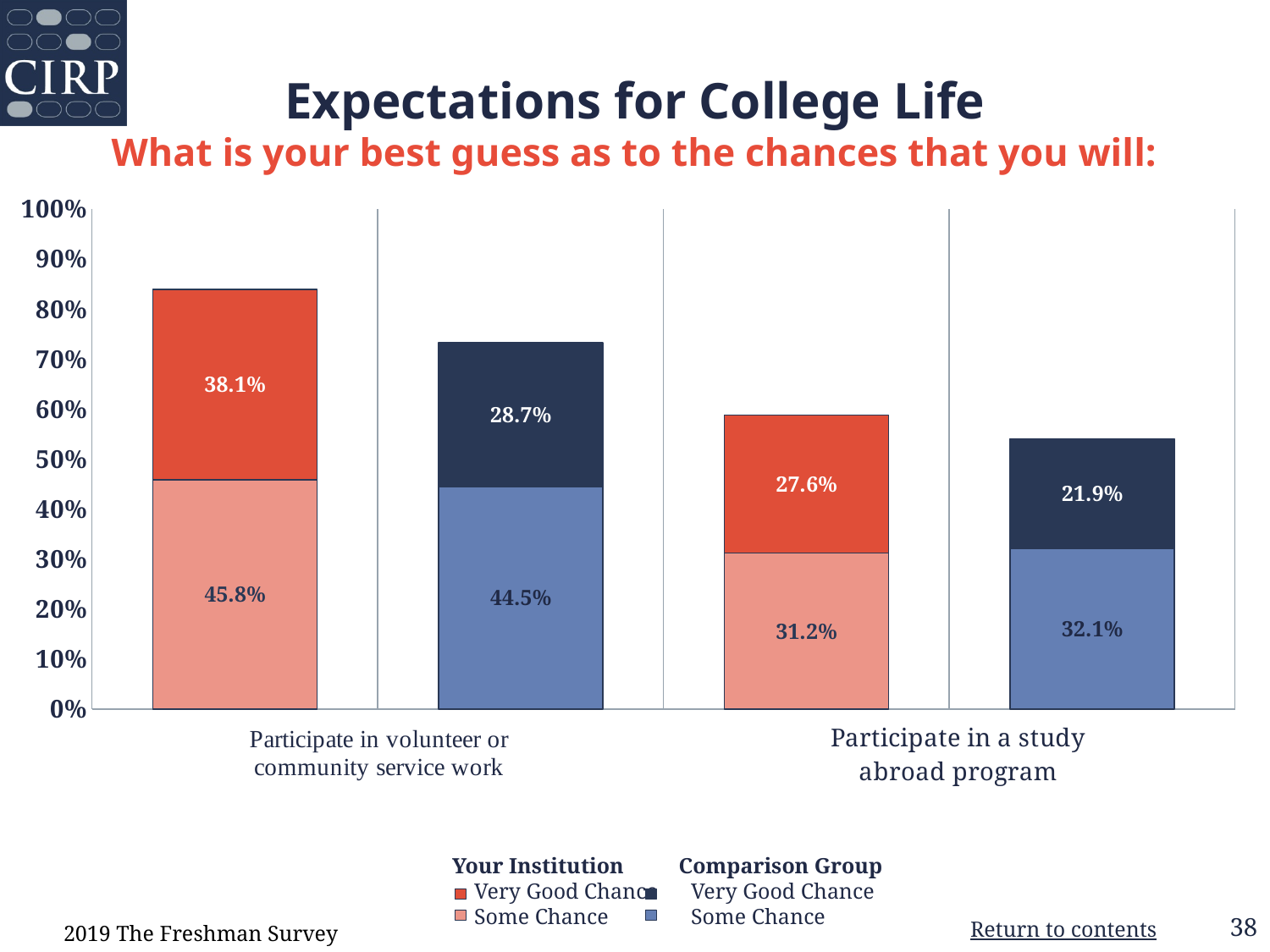
How many entries does the legend list? 4 Which of the four stacked bars has the lowest Very Good Chance value? Comparison Group, Participate in a study abroad program (21.9%) What is the difference between Your Institution and the Comparison Group in the Very Good Chance share for participating in a study abroad program? 5.7% What type of chart is shown on the slide? Stacked bar chart What percentage of Your Institution students said there is a Very Good Chance they will participate in volunteer or community service work? 38.1% What percentage of the Comparison Group said there is a Very Good Chance they will participate in volunteer or community service work? 28.7% Is the total height of the Comparison Group bar for participating in volunteer or community service work greater or less than 70%? greater What percentage of the Comparison Group said there is Some Chance they will participate in a study abroad program? 32.1% What is the subtitle question shown in red above the chart? What is your best guess as to the chances that you will: What is the combined percentage (Very Good Chance plus Some Chance) for the Comparison Group on participating in a study abroad program? 54.0% Which group has the larger Very Good Chance share for participating in volunteer or community service work, Your Institution or the Comparison Group? Your Institution What is the combined percentage (Very Good Chance plus Some Chance) for Your Institution on participating in volunteer or community service work? 83.9%